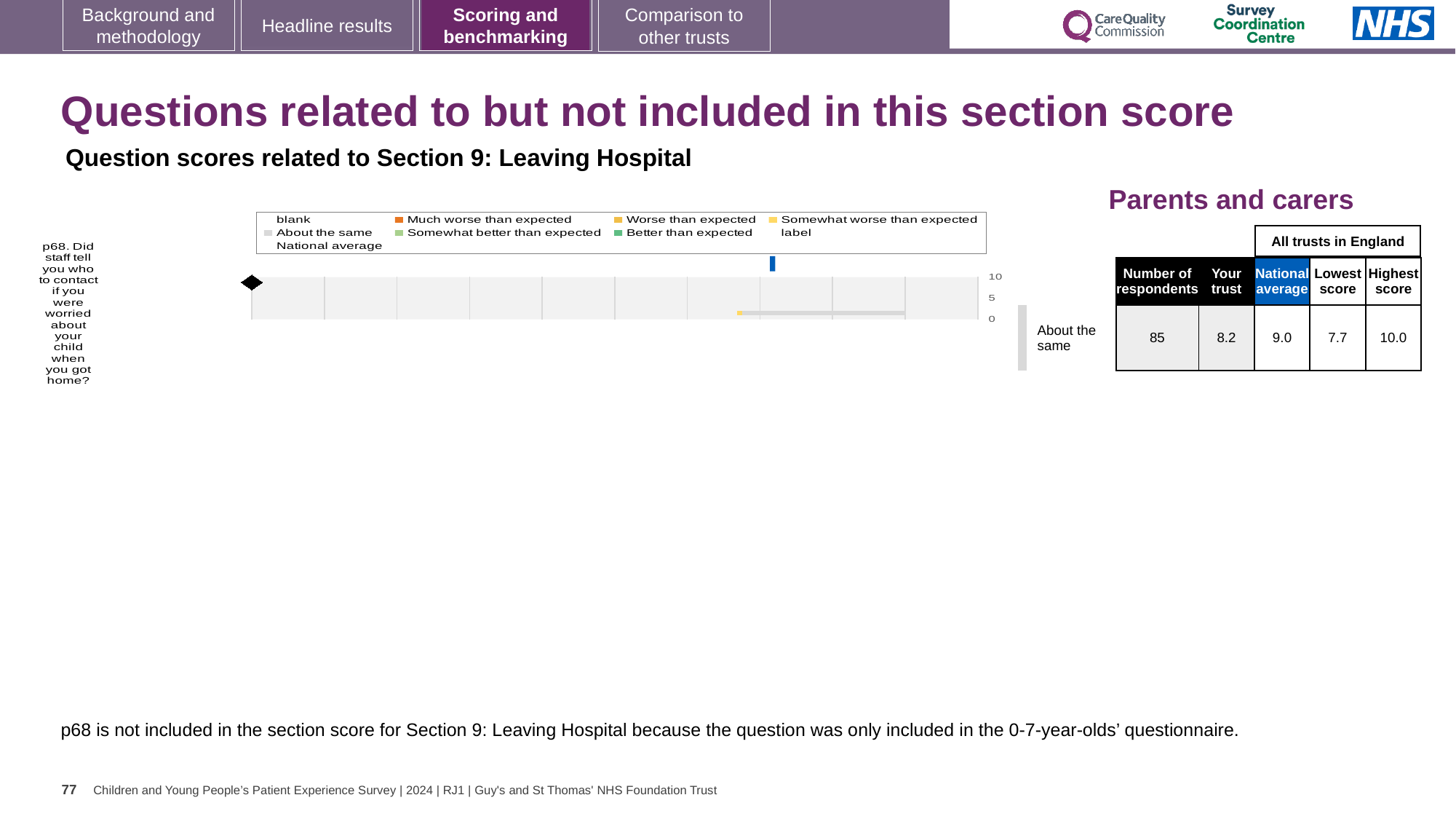
What is the Lowest score across all trusts in England for question p68? 7.7 What is the Highest score across all trusts in England for question p68? 10.0 What is the National average score for question p68? 9.0 What comparison category is question p68 assigned to on the chart? About the same What is the difference between the National average and the 'Your trust' score for question p68? 0.8 Which is larger for question p68, the 'Your trust' score or the National average? National average How many survey questions are plotted on the chart? 1 What is the 'Your trust' score for question p68? 8.2 What is the highest tick value shown on the chart's axis? 10 How many respondents answered question p68? 85 Which legend entry is shown with the dark green marker? Better than expected What kind of chart is shown on the slide? bar chart